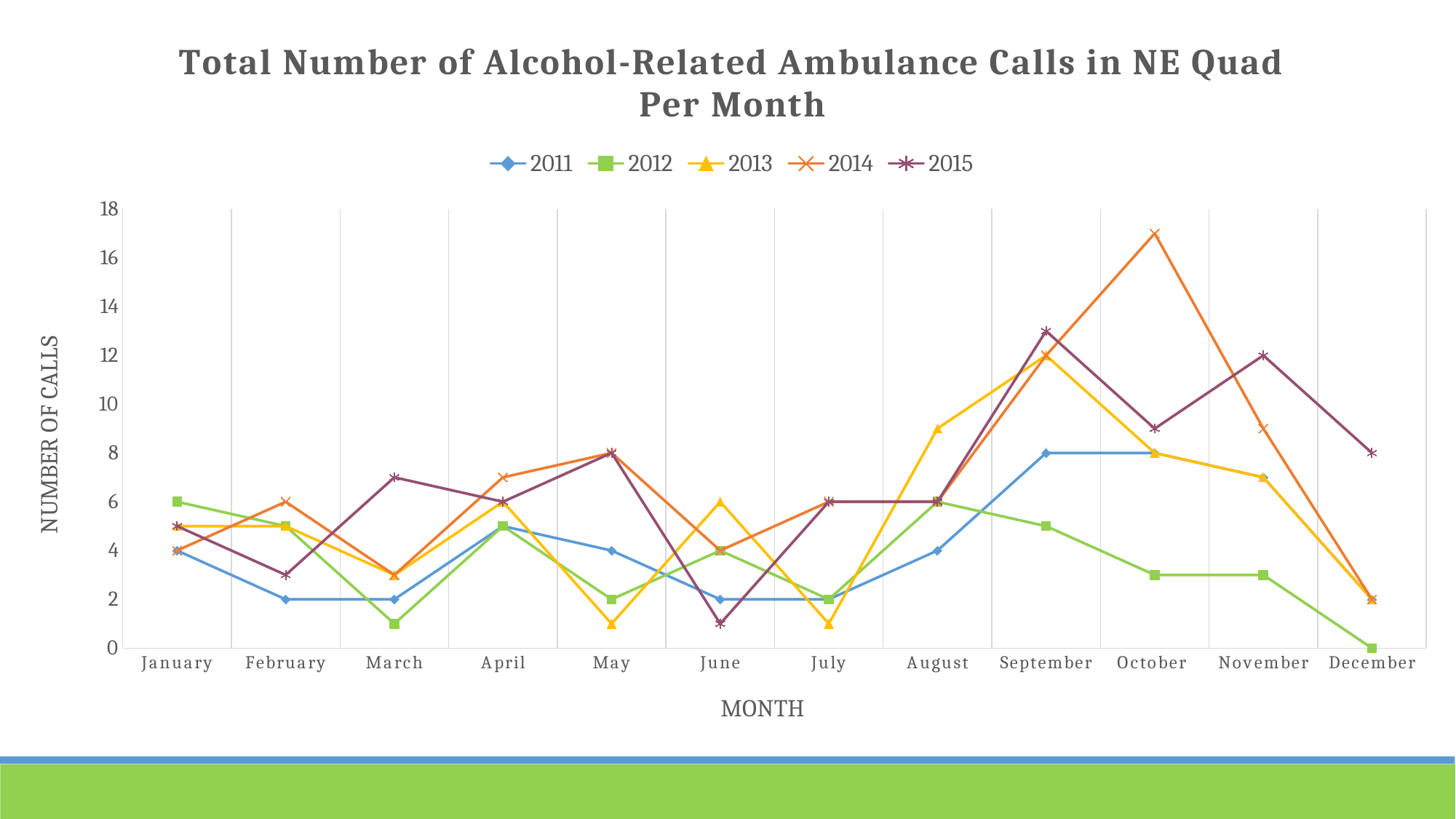
Do the values for 2012 rise or fall from September to December? fall Is the value for 2014 in October greater or less than 16? greater How many months are plotted along the x axis? 12 Is the value for 2015 in September greater or less than 12? greater What kind of chart is shown on the slide? line chart Which series and month has the highest number of calls on the chart? 2014, October What is the difference between the 2013 and 2011 values in September? 4 What is the number of calls for 2015 in November? 12 What is the number of calls for 2012 in December? 0 What is the number of calls for 2011 in October? 8 How many series does the legend list? 5 In October, which series has the larger value, 2014 or 2015? 2014